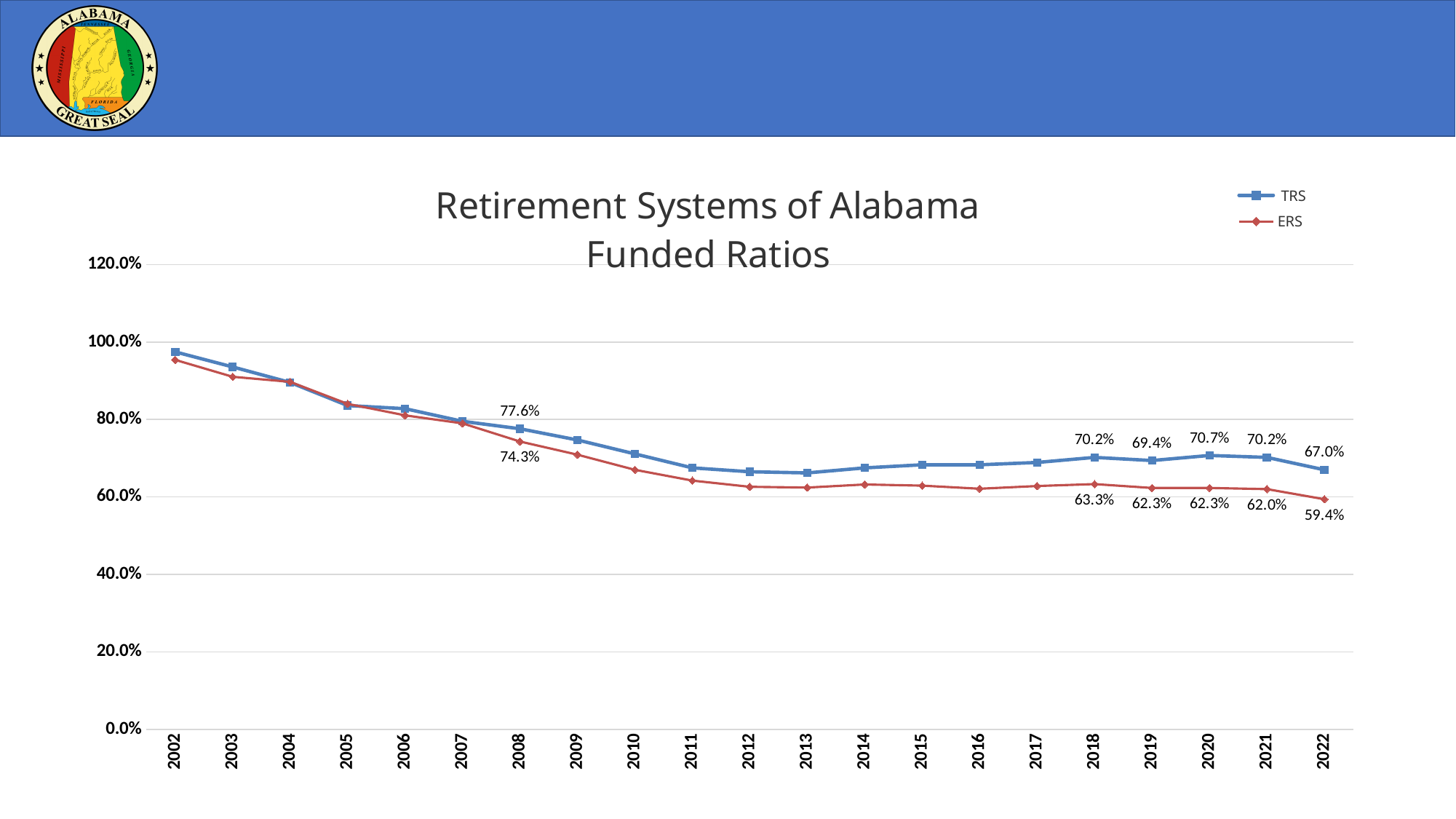
What is the difference between the TRS and ERS funded ratios in 2008? 3.3% How many years are shown on the x axis? 21 Which series has the higher funded ratio in 2021, TRS or ERS? TRS What kind of chart is shown on the slide? Line chart Is the TRS funded ratio in 2012 greater or less than 80.0%? less How many series does the legend list? 2 What is the ERS funded ratio in 2018? 63.3% What is the TRS funded ratio in 2020? 70.7% What is the difference between the TRS and ERS funded ratios in 2022? 7.6% Is the ERS funded ratio in 2002 greater or less than 80.0%? greater What is the TRS funded ratio in 2008? 77.6% What is the ERS funded ratio in 2022? 59.4%